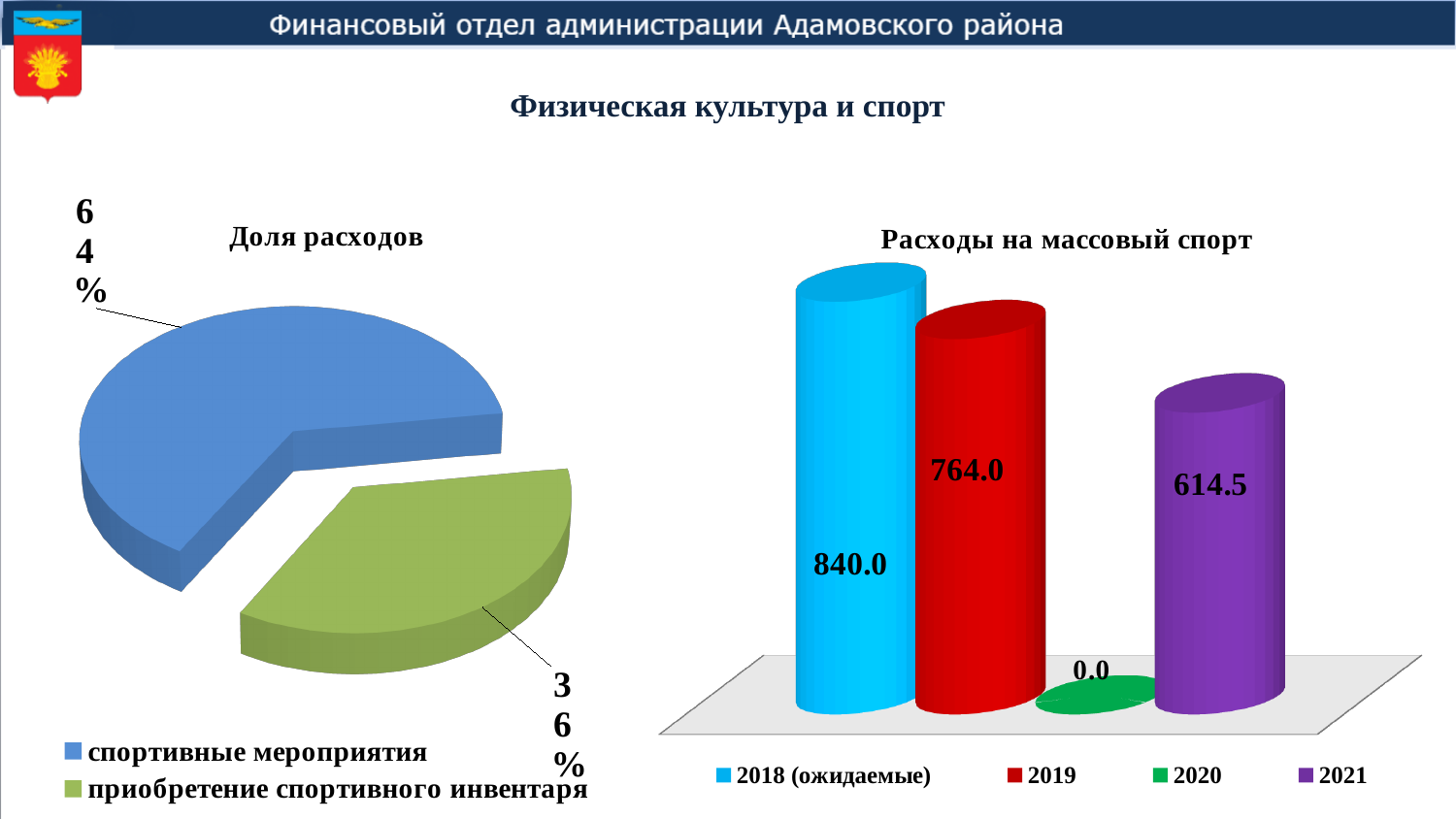
How many entries does the legend of the pie chart 'Доля расходов' list? 2 In the chart 'Расходы на массовый спорт', how many years are shown? 4 In the chart 'Расходы на массовый спорт', what is the value for 2021? 614.5 In the chart 'Расходы на массовый спорт', which year has the highest value? 2018 (ожидаемые) In the chart 'Расходы на массовый спорт', what is the value for 2018 (ожидаемые)? 840.0 In the pie chart 'Доля расходов', what share does 'спортивные мероприятия' have? 64% In the chart 'Расходы на массовый спорт', which is larger: the value for 2019 or the value for 2021? 2019 In the pie chart 'Доля расходов', what share does 'приобретение спортивного инвентаря' have? 36% In the chart 'Расходы на массовый спорт', what is the difference between the values for 2018 (ожидаемые) and 2019? 76.0 In the chart 'Расходы на массовый спорт', which year has the lowest value? 2020 In the chart 'Расходы на массовый спорт', what is the value for 2019? 764.0 What kind of chart is 'Расходы на массовый спорт'? bar chart